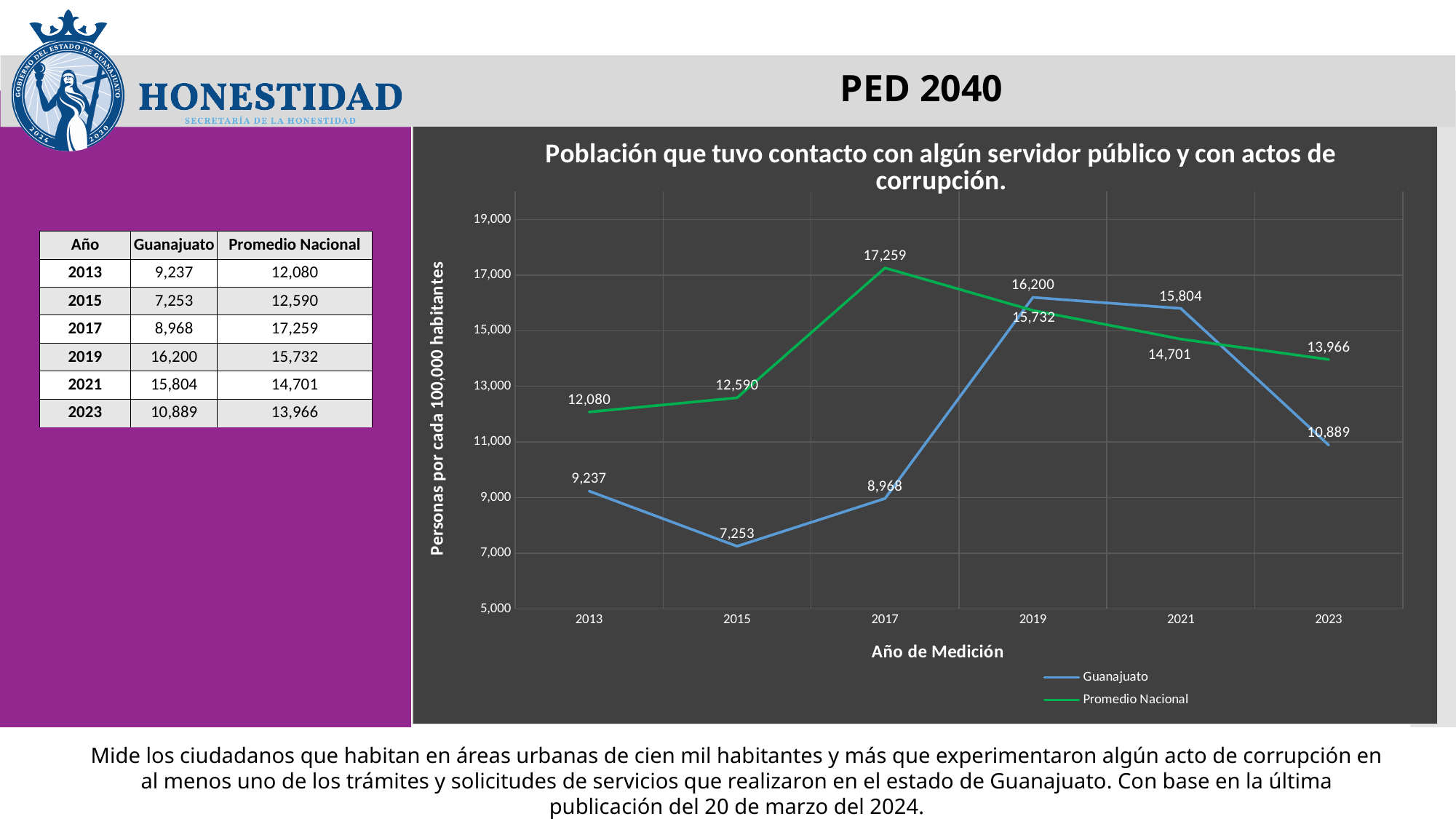
How many years are plotted on the x axis? 6 What kind of chart is shown? line chart In which year is the Guanajuato series at its lowest? 2015 What is the difference between the Promedio Nacional and Guanajuato values in 2017? 8,291 How many series does the legend list? 2 In which year is the Promedio Nacional series at its highest? 2017 Which series has the larger value in 2021, Guanajuato or Promedio Nacional? Guanajuato What is the Promedio Nacional value for 2017? 17,259 Is the Guanajuato value for 2013 greater or less than 11,000? less Does the Guanajuato series rise or fall from 2019 to 2023? fall What is the Guanajuato value for 2023? 10,889 What is the Guanajuato value for 2019? 16,200